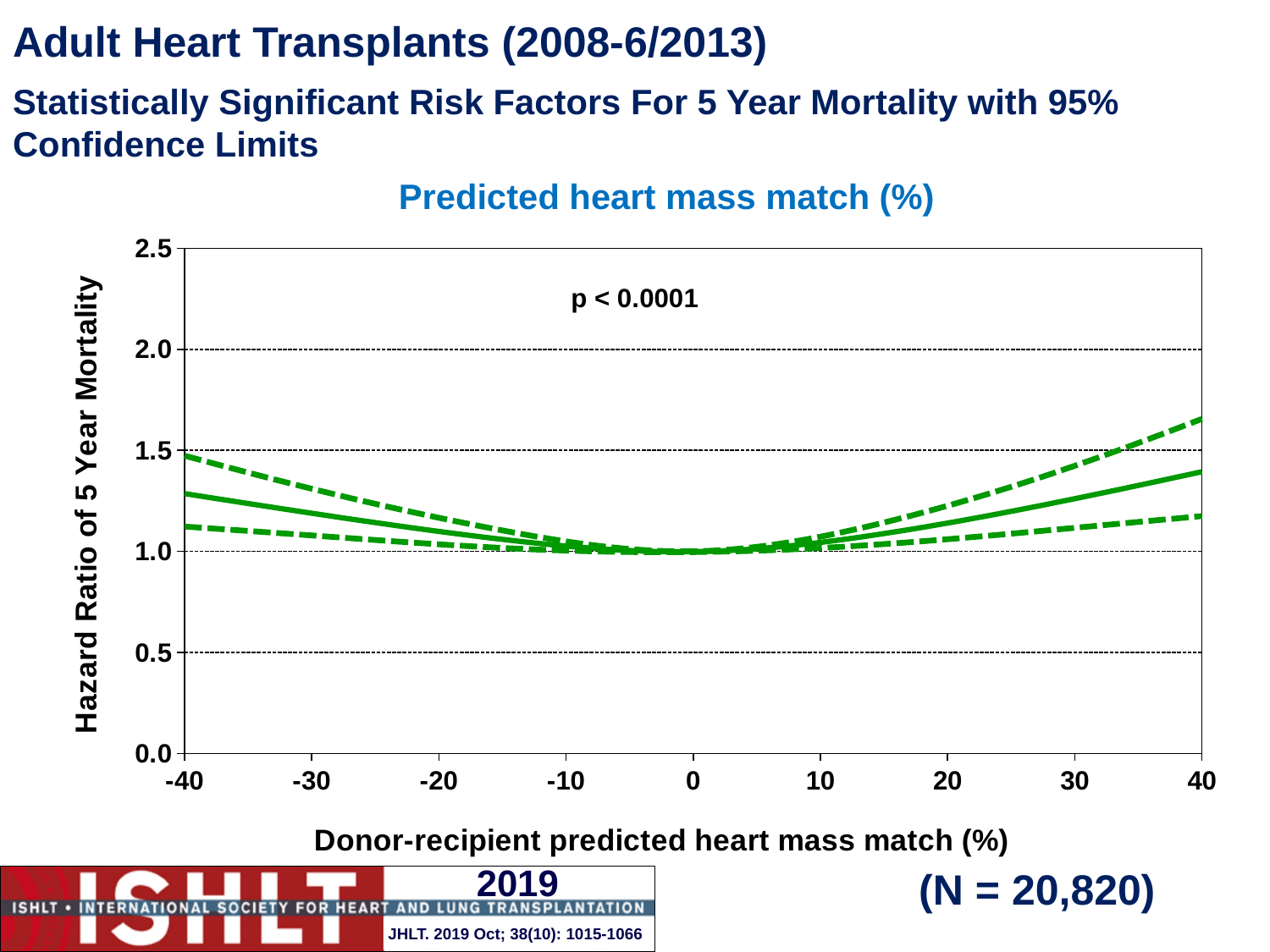
Is the lower dashed confidence limit at a predicted heart mass match of 40% greater or less than 1.5? less Is the upper dashed confidence limit higher at a predicted heart mass match of 40% or at -40%? 40% What kind of chart is shown on the slide? line chart What is the title of the chart? Predicted heart mass match (%) Is the hazard ratio shown by the solid line at a predicted heart mass match of 40% greater or less than 1.5? less Does the solid hazard ratio line rise or fall as the predicted heart mass match goes from -40% to 0%? fall Does the solid hazard ratio line rise or fall as the predicted heart mass match goes from 0% to 40%? rise What is the label of the y axis? Hazard Ratio of 5 Year Mortality Is the hazard ratio shown by the solid line at a predicted heart mass match of -40% greater or less than 1.0? greater How many lines are plotted on the chart? 3 What p-value is printed on the chart? p < 0.0001